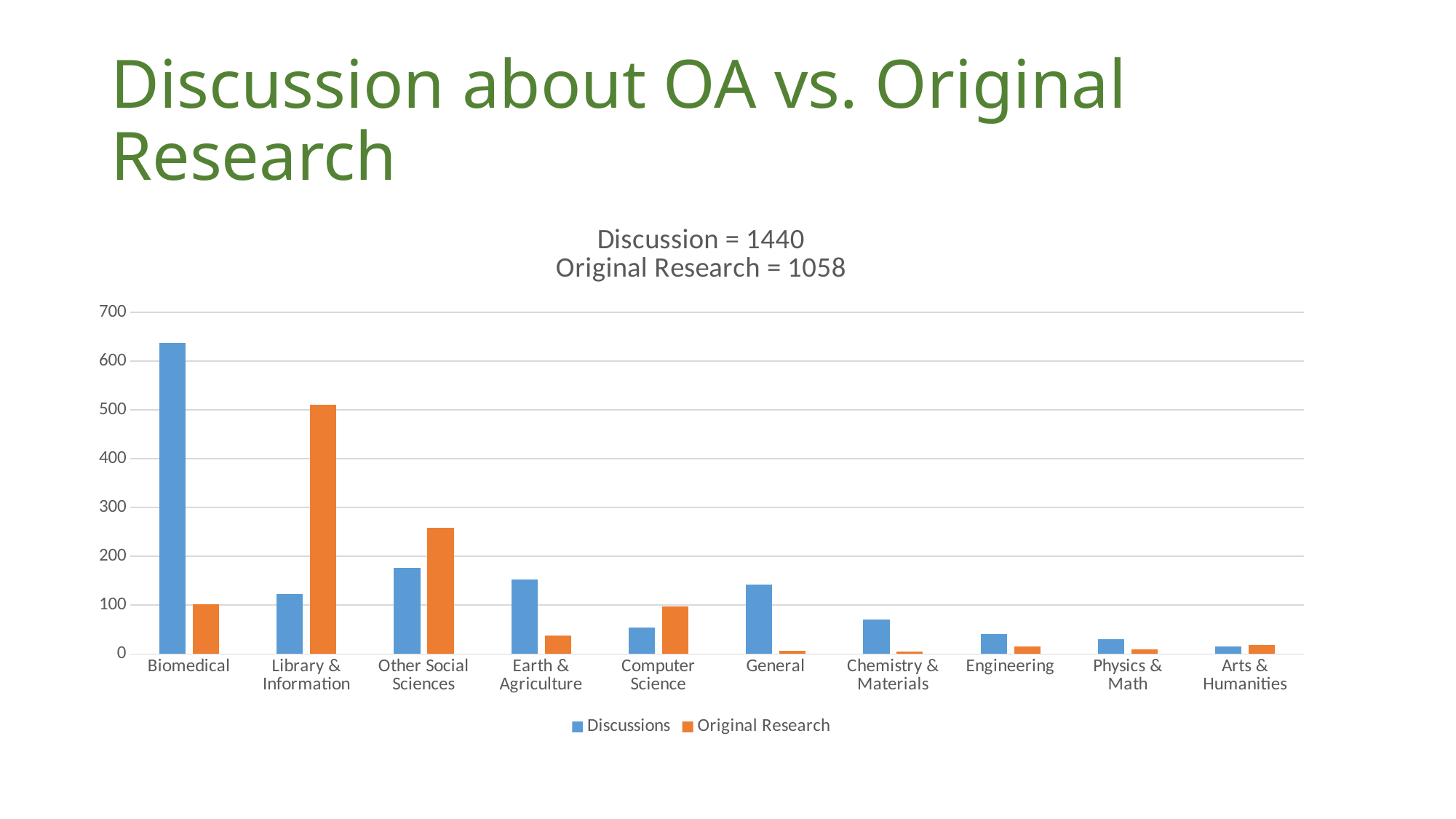
What total is given for Original Research in the chart title? 1058 Which category has the lowest Discussions value? Arts & Humanities What kind of chart is shown on the slide? Bar chart For Biomedical, which is larger: Discussions or Original Research? Discussions Which category has the highest Original Research value? Library & Information Is the Discussions value for Chemistry & Materials greater or less than 100? less Which category has the highest Discussions value? Biomedical How many categories are shown on the x axis? 10 Is the Discussions value for Biomedical greater or less than 600? greater For Library & Information, which is larger: Discussions or Original Research? Original Research How many series does the legend list? 2 Is the Original Research value for Other Social Sciences greater or less than 200? greater